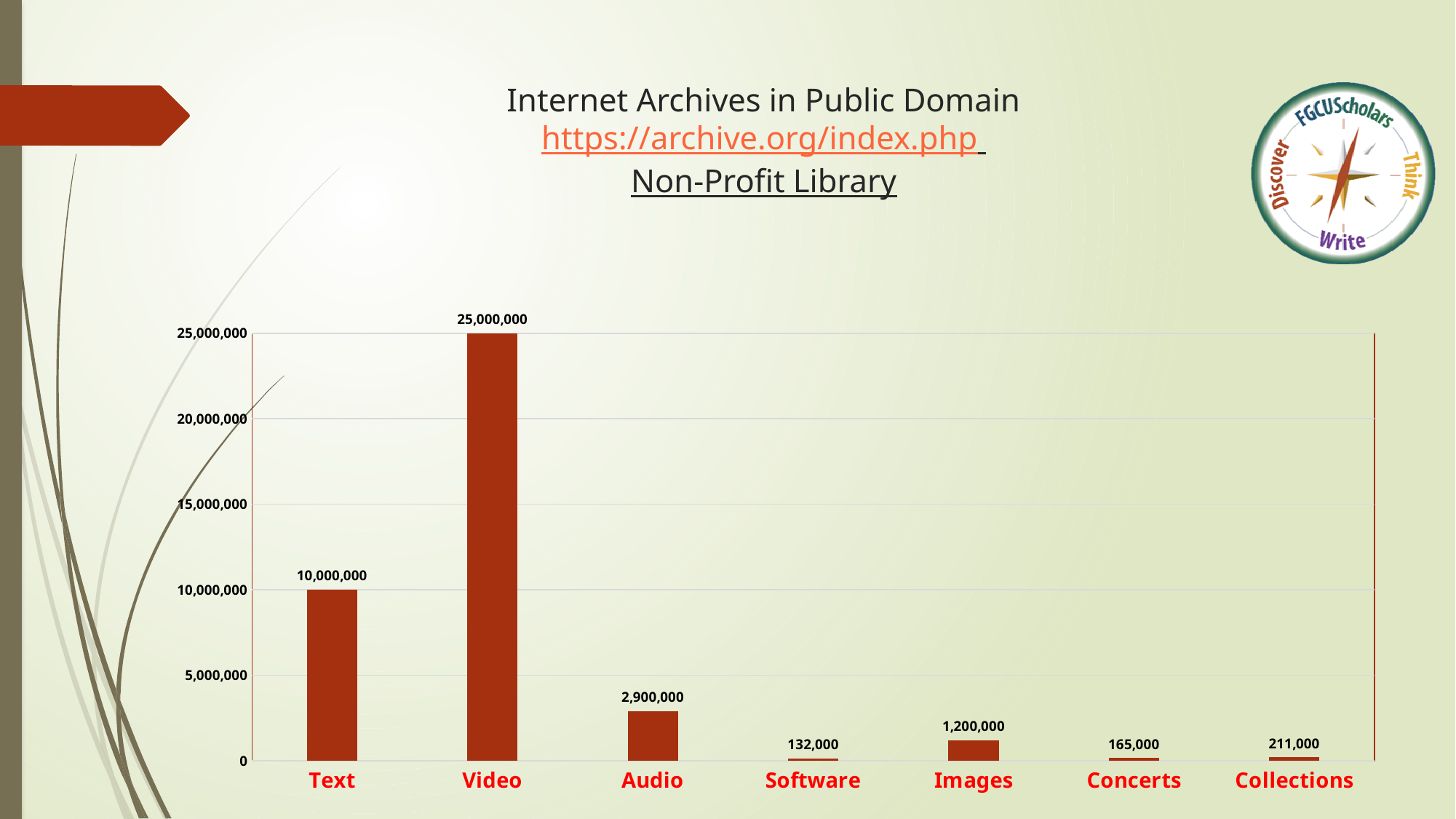
What is the value for Audio? 2,900,000 What is the difference between the values for Video and Text? 15,000,000 What is the difference between the values for Collections and Concerts? 46,000 What is the value for Text? 10,000,000 What is the value for Collections? 211,000 Which category has the highest value? Video How many categories are shown on the x axis? 7 What is the value for Video? 25,000,000 What is the value for Software? 132,000 Which is larger, the value for Images or the value for Audio? Audio What kind of chart is shown on the slide? Bar chart Which category has the lowest value? Software